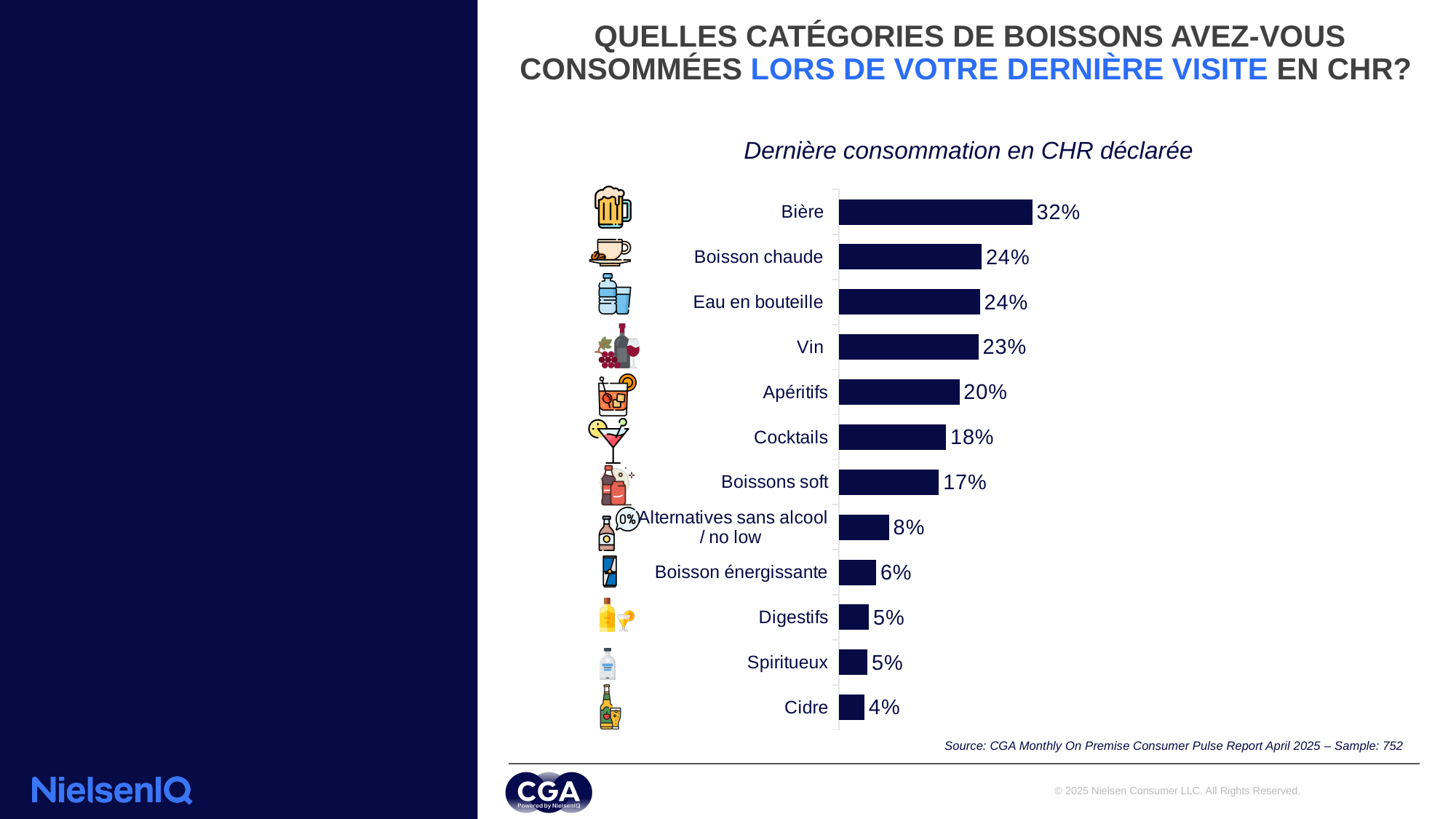
What is the value for Alternatives sans alcool / no low? 8% What is the difference between the values for Cocktails and Boissons soft? 1% What is the value for Apéritifs? 20% What is the value for Boisson énergissante? 6% What is the subtitle shown above the chart? Dernière consommation en CHR déclarée Which is larger, the value for Apéritifs or the value for Cocktails? Apéritifs What is the value for Bière? 32% Which category has the lowest value? Cidre What kind of chart is shown on the slide? Bar chart What is the difference between the values for Bière and Vin? 9% Which category has the highest value? Bière How many categories are shown in the chart? 12